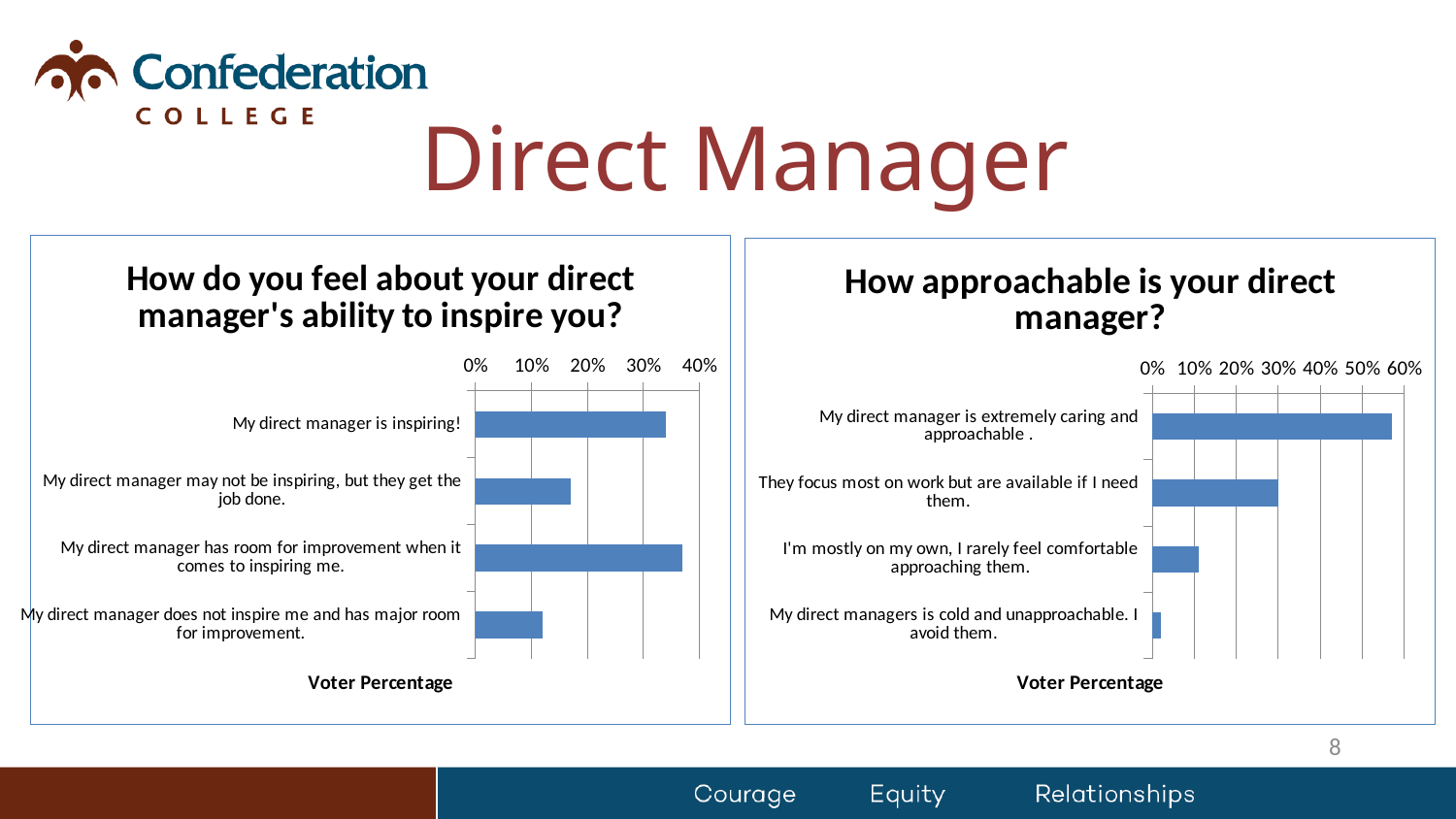
In the 'How do you feel about your direct manager's ability to inspire you?' chart, is the value for 'My direct manager is inspiring!' greater or less than 30%? greater In the 'How approachable is your direct manager?' chart, which category has the lowest value? My direct managers is cold and unapproachable. I avoid them. What type of chart is used in the 'How approachable is your direct manager?' chart? bar chart In the 'How do you feel about your direct manager's ability to inspire you?' chart, which category has the lowest value? My direct manager does not inspire me and has major room for improvement. In the 'How approachable is your direct manager?' chart, which category has the highest value? My direct manager is extremely caring and approachable . In the 'How do you feel about your direct manager's ability to inspire you?' chart, how many categories are shown? 4 In the 'How do you feel about your direct manager's ability to inspire you?' chart, which is larger: the value for 'My direct manager is inspiring!' or the value for 'My direct manager may not be inspiring, but they get the job done.'? My direct manager is inspiring! In the 'How approachable is your direct manager?' chart, is the value for 'My direct manager is extremely caring and approachable .' greater or less than 50%? greater In the 'How approachable is your direct manager?' chart, is the value for 'My direct managers is cold and unapproachable. I avoid them.' greater or less than 10%? less What is the x-axis title of the 'How approachable is your direct manager?' chart? Voter Percentage In the 'How approachable is your direct manager?' chart, which is larger: the value for 'They focus most on work but are available if I need them.' or the value for 'I'm mostly on my own, I rarely feel comfortable approaching them.'? They focus most on work but are available if I need them.